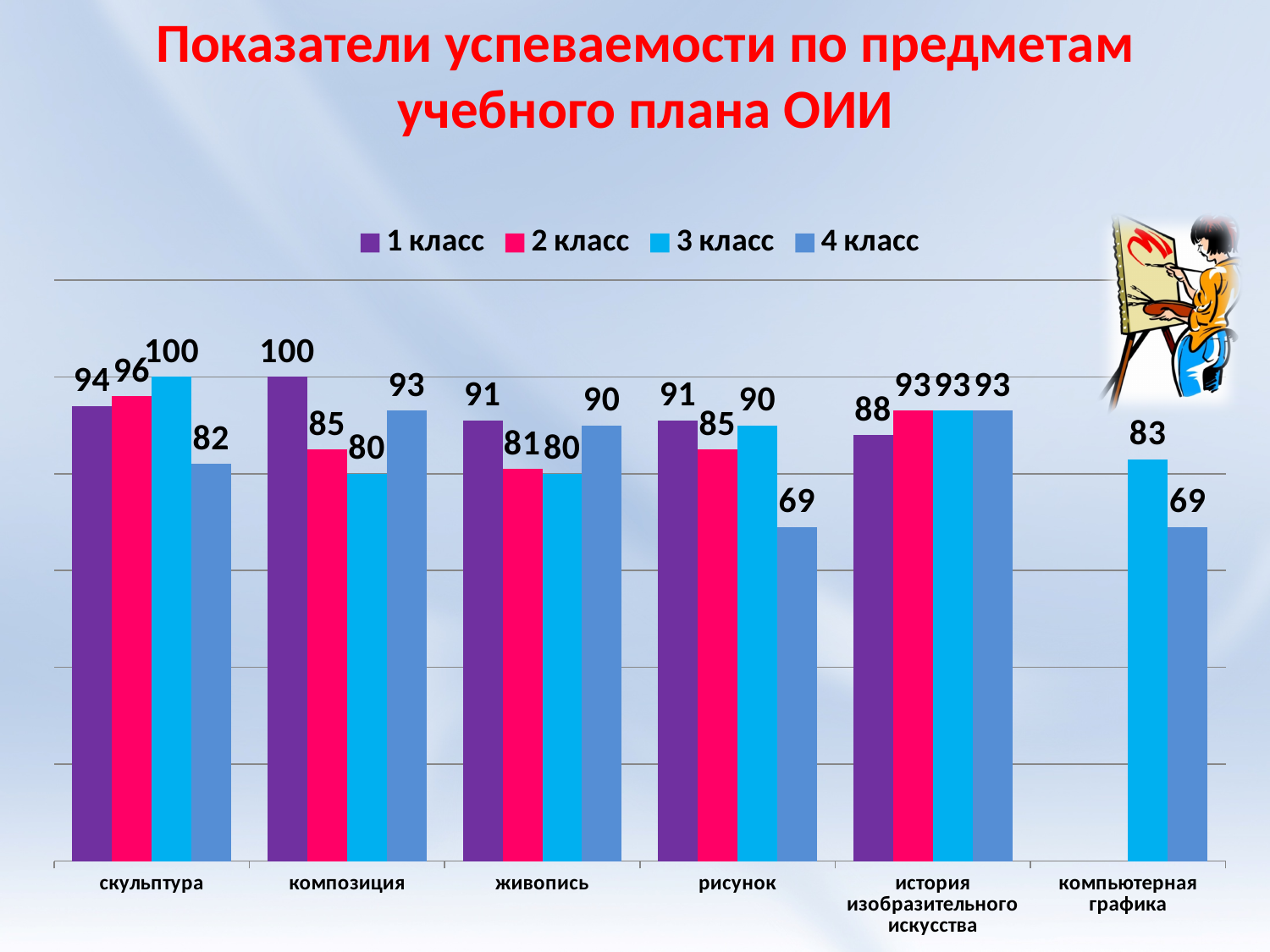
Which series is shown in pink/magenta in the legend? 2 класс What is the value for 4 класс in рисунок? 69 Which subject has the lowest value for 4 класс? рисунок and компьютерная графика (both 69) Which is larger in живопись: the value for 1 класс or the value for 2 класс? 1 класс What type of chart is shown on the slide? bar chart How many series does the legend list? 4 What is the value for 3 класс in компьютерная графика? 83 What is the difference between the 1 класс and 3 класс values in композиция? 20 What is the value for 1 класс in история изобразительного искусства? 88 What is the value for 3 класс in скульптура? 100 How many subject categories are shown on the x axis? 6 Which subject has the highest value for 1 класс? композиция